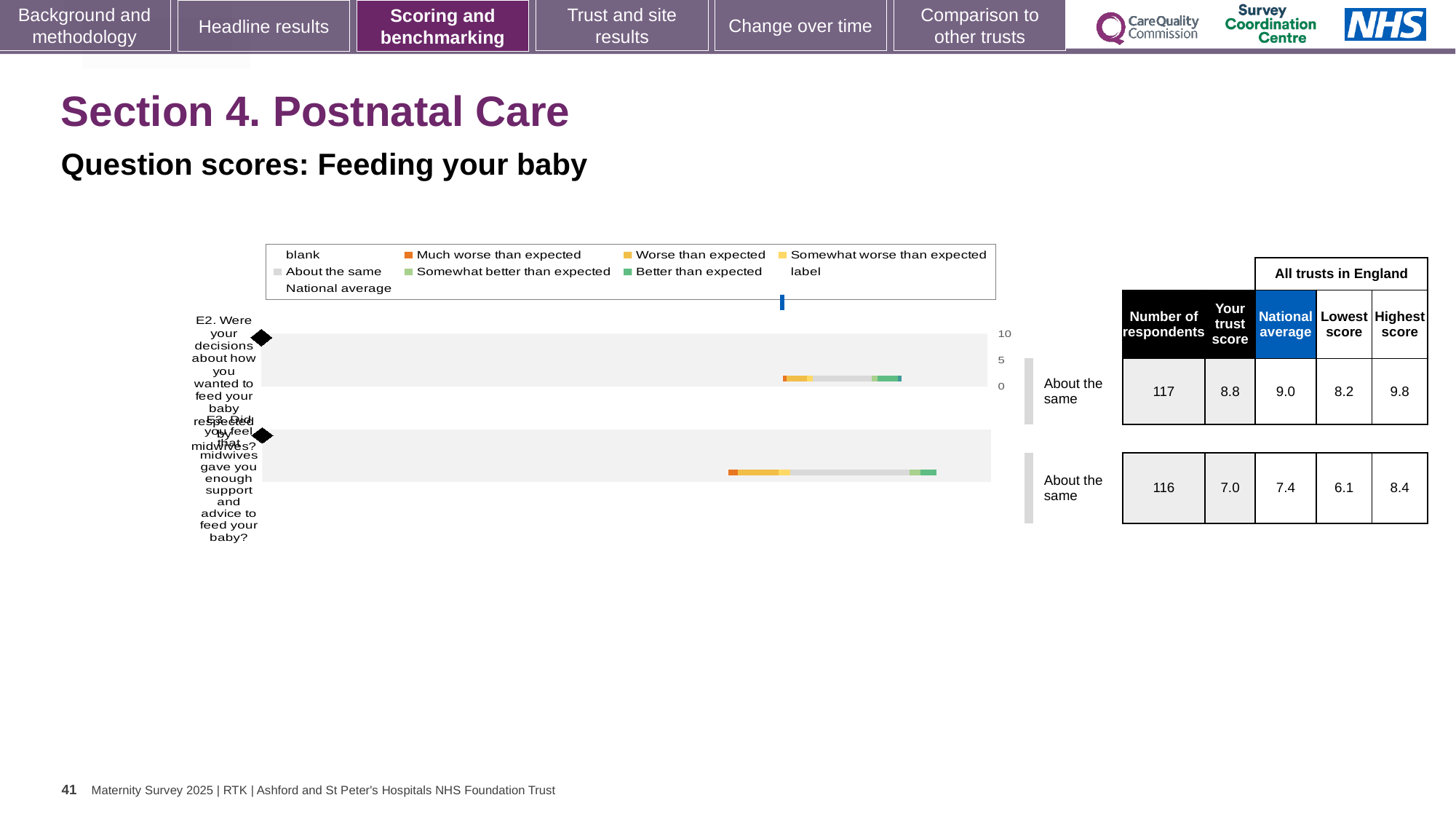
What colour represents 'Much worse than expected' in the legend? Orange How many respondents answered question E3? 116 For question E2, is the trust score or the national average higher? National average What is the 'Your trust score' for question E2 about decisions on how you wanted to feed your baby? 8.8 What benchmark category is shown next to the bar for question E2? About the same What is the national average score for question E3 about midwives giving enough support and advice to feed your baby? 7.4 What kind of chart is shown on the slide? Bar chart What is the difference between the highest score and the lowest score for question E2? 1.6 What is the lowest score among all trusts in England for question E3? 6.1 What is the difference between the national average and the trust score for question E3? 0.4 How many questions (categories) are plotted in the chart? 2 Which question has the higher trust score, E2 or E3? E2